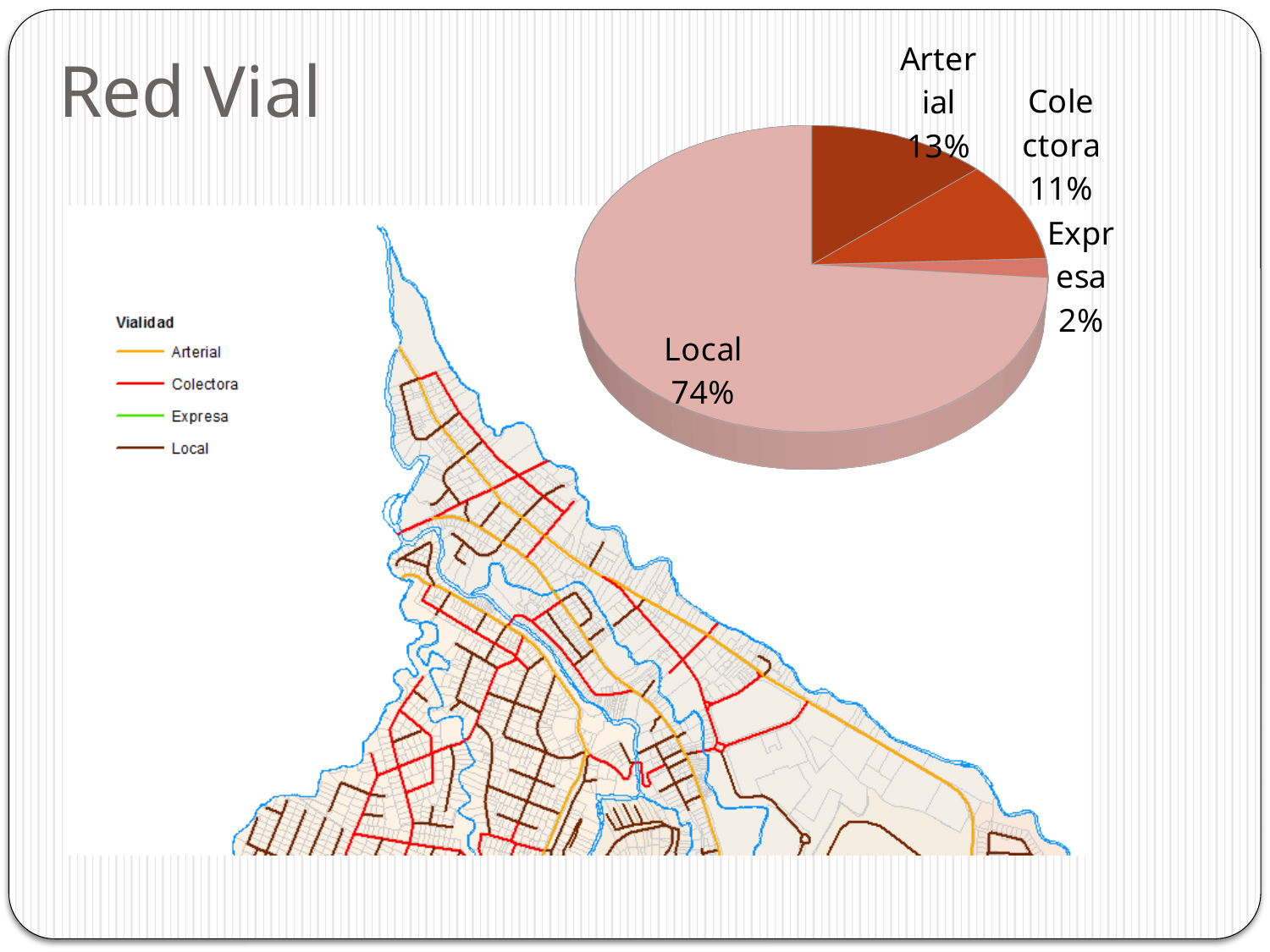
Which category has the largest slice in the pie chart? Local What kind of chart is shown on the slide? pie chart What is the title of the slide containing the pie chart? Red Vial What percentage is shown for Colectora in the pie chart? 11% What is the difference in percentage points between Arterial and Colectora in the pie chart? 2 What is the difference in percentage points between Local and Arterial in the pie chart? 61 Which is larger in the pie chart, Arterial or Colectora? Arterial What share of the pie chart does Local represent? 74% How many slices does the pie chart have? 4 Which category has the smallest slice in the pie chart? Expresa What percentage is shown for Arterial in the pie chart? 13% What percentage is shown for Expresa in the pie chart? 2%